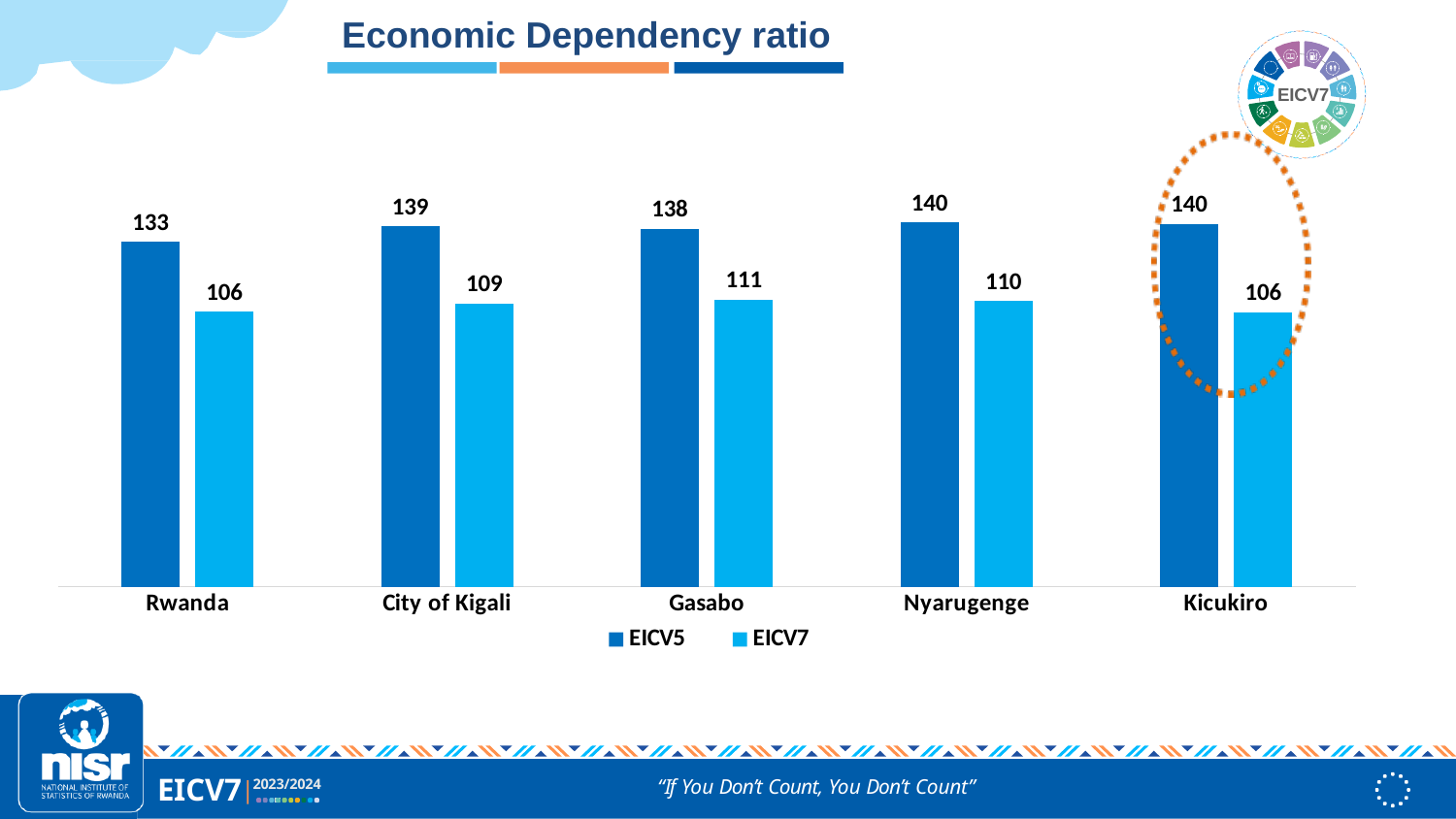
How many categories are shown on the x axis? 5 Which category has the lowest EICV5 value? Rwanda What is the EICV7 value for City of Kigali? 109 What is the EICV5 value for Nyarugenge? 140 What is the EICV7 value for Gasabo? 111 How many series does the legend list? 2 What is the difference between the EICV5 and EICV7 values for Kicukiro? 34 What is the difference between the EICV5 values for City of Kigali and Rwanda? 6 What is the EICV5 value for Rwanda? 133 Which category has the highest EICV7 value? Gasabo Which is larger for Nyarugenge, the EICV5 value or the EICV7 value? EICV5 What type of chart is shown on the slide? Bar chart